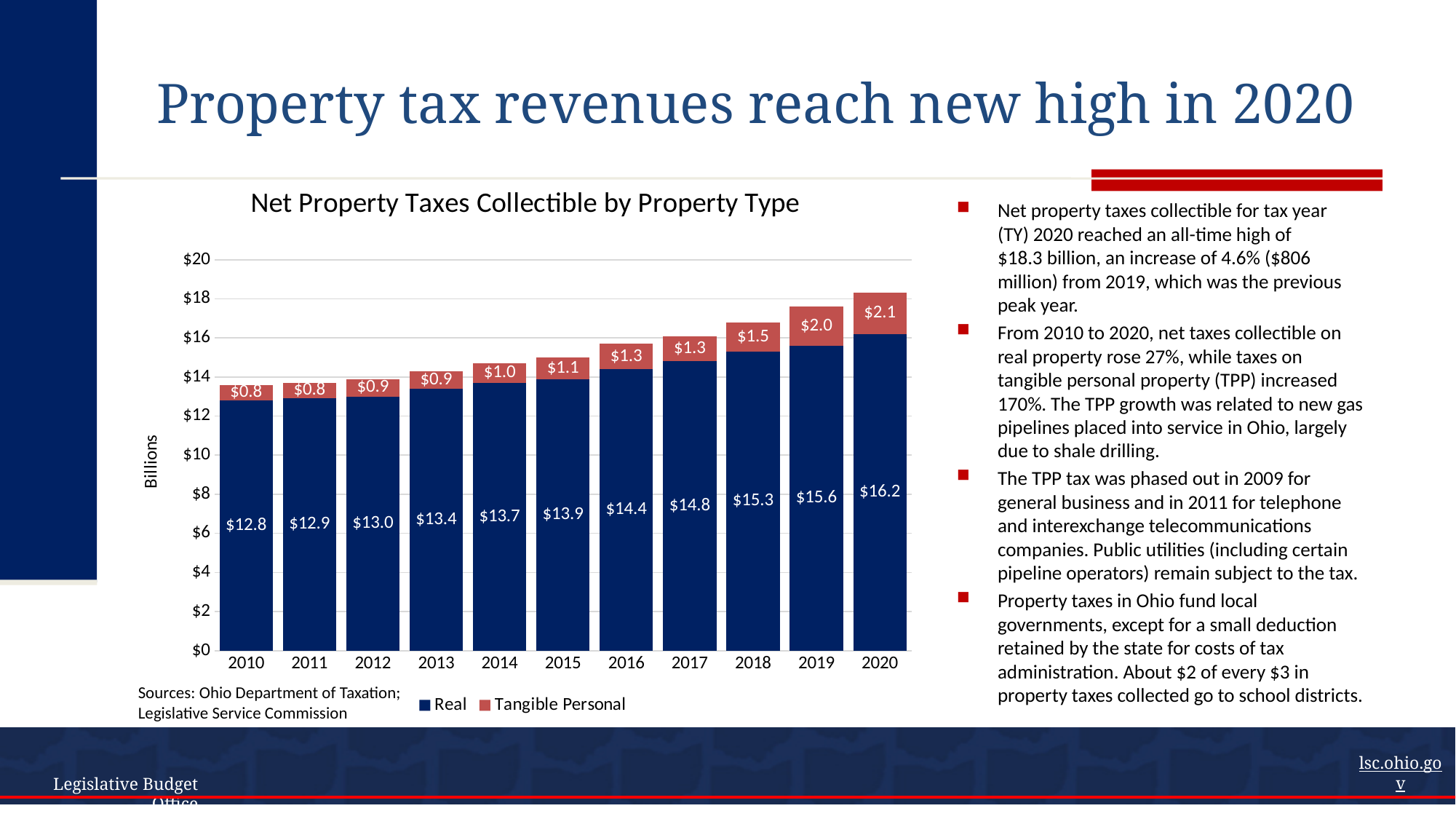
Which year has the highest Real property tax value? 2020 What kind of chart is shown? Stacked bar chart What is the difference between the Real property tax values for 2020 and 2010? $3.4 Do the Real property tax values rise or fall from 2010 to 2020? Rise Is the total stacked bar for 2020 greater or less than $18? greater How many years are shown on the x axis? 11 What is the value of Tangible Personal property taxes collectible in 2019? $2.0 How many series does the legend list? 2 Which is larger, the Tangible Personal value for 2016 or for 2018? 2018 What is the value of Real property taxes collectible in 2020? $16.2 What is the value of Real property taxes collectible in 2010? $12.8 Which year has the lowest Real property tax value? 2010